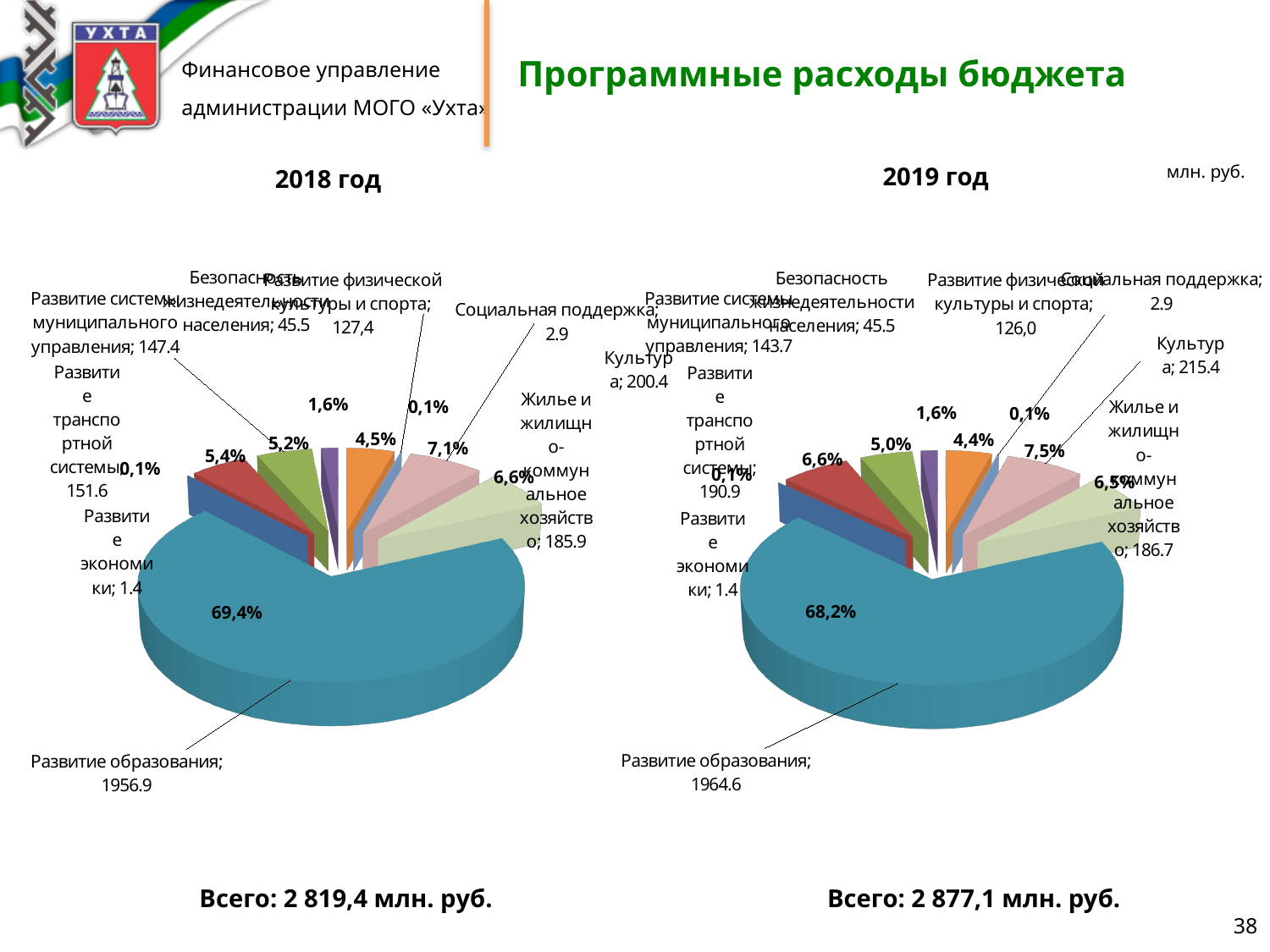
On the 2018 год chart, what is the value for Развитие образования? 1956.9 On the 2018 год chart, what share of the pie does Развитие образования take? 69,4% What total is stated below the 2019 год chart? 2 877,1 млн. руб. On the 2019 год chart, which is larger: Культура or Жилье и жилищно-коммунальное хозяйство? Культура What is the difference between the value for Развитие образования on the 2019 год chart and on the 2018 год chart? 7.7 How many categories are shown on the 2018 год chart? 9 On the 2019 год chart, which category has the smallest value? Развитие экономики On the 2018 год chart, which category has the largest slice? Развитие образования What type of chart is used for 2018 год? Pie chart On the 2019 год chart, what share of the pie does Развитие образования take? 68,2% On the 2019 год chart, what is the value for Развитие образования? 1964.6 On the 2019 год chart, what is the value for Культура? 215.4